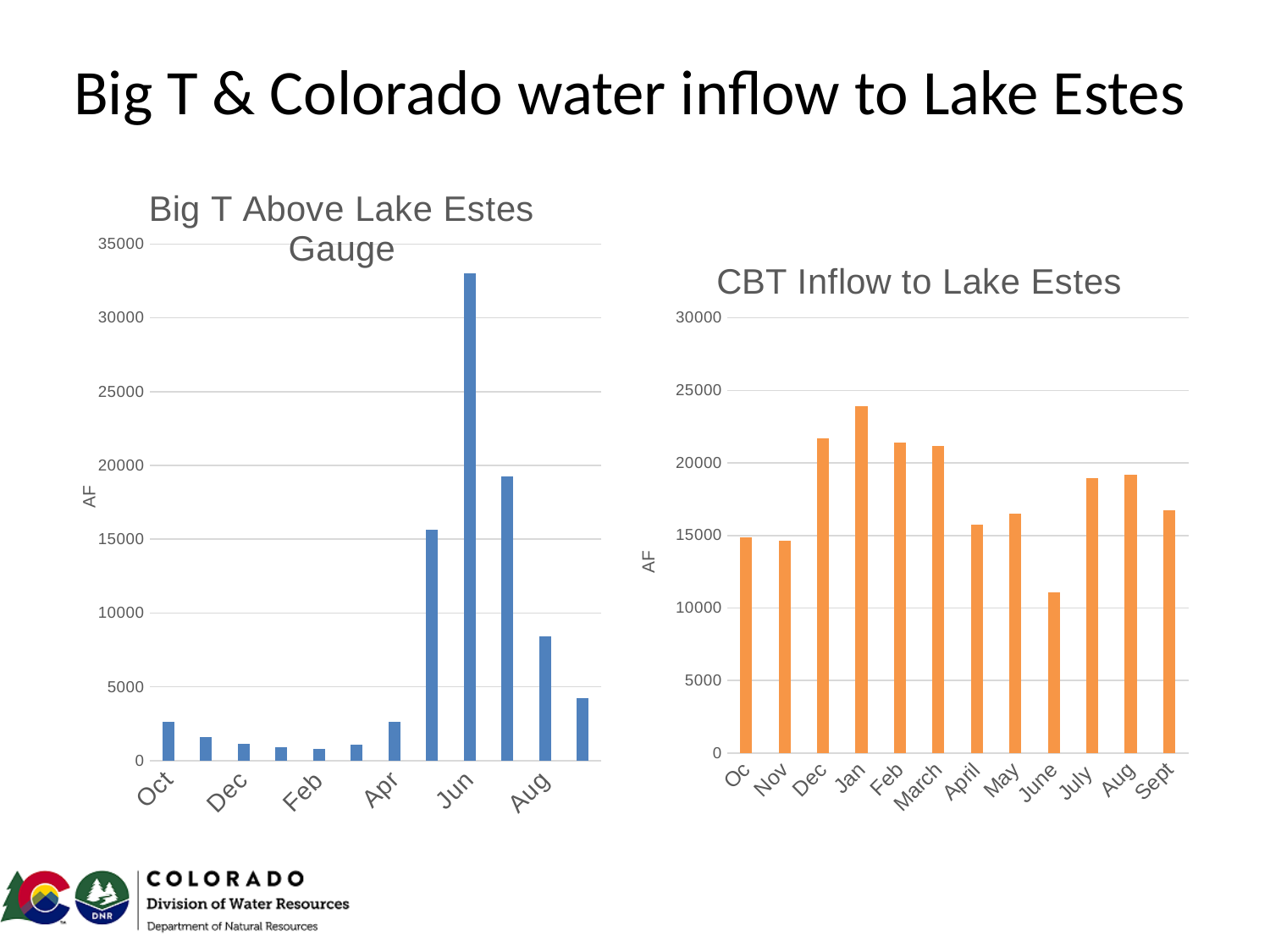
In the 'CBT Inflow to Lake Estes' chart, which month has the highest value? Jan In the 'CBT Inflow to Lake Estes' chart, is the value for June greater or less than 15000? less In the 'Big T Above Lake Estes Gauge' chart, which is larger, the value for Jun or the value for Aug? Jun What label is shown on the vertical axis of the 'CBT Inflow to Lake Estes' chart? AF In the 'Big T Above Lake Estes Gauge' chart, is the value for Jun greater or less than 30000? greater What kind of chart is the 'CBT Inflow to Lake Estes' chart? bar chart In the 'CBT Inflow to Lake Estes' chart, which month has the lowest value? June In the 'Big T Above Lake Estes Gauge' chart, which month has the highest value? Jun In the 'CBT Inflow to Lake Estes' chart, is the value for Jan greater or less than 20000? greater In the 'CBT Inflow to Lake Estes' chart, how many bars are plotted? 12 What kind of chart is the 'Big T Above Lake Estes Gauge' chart? bar chart